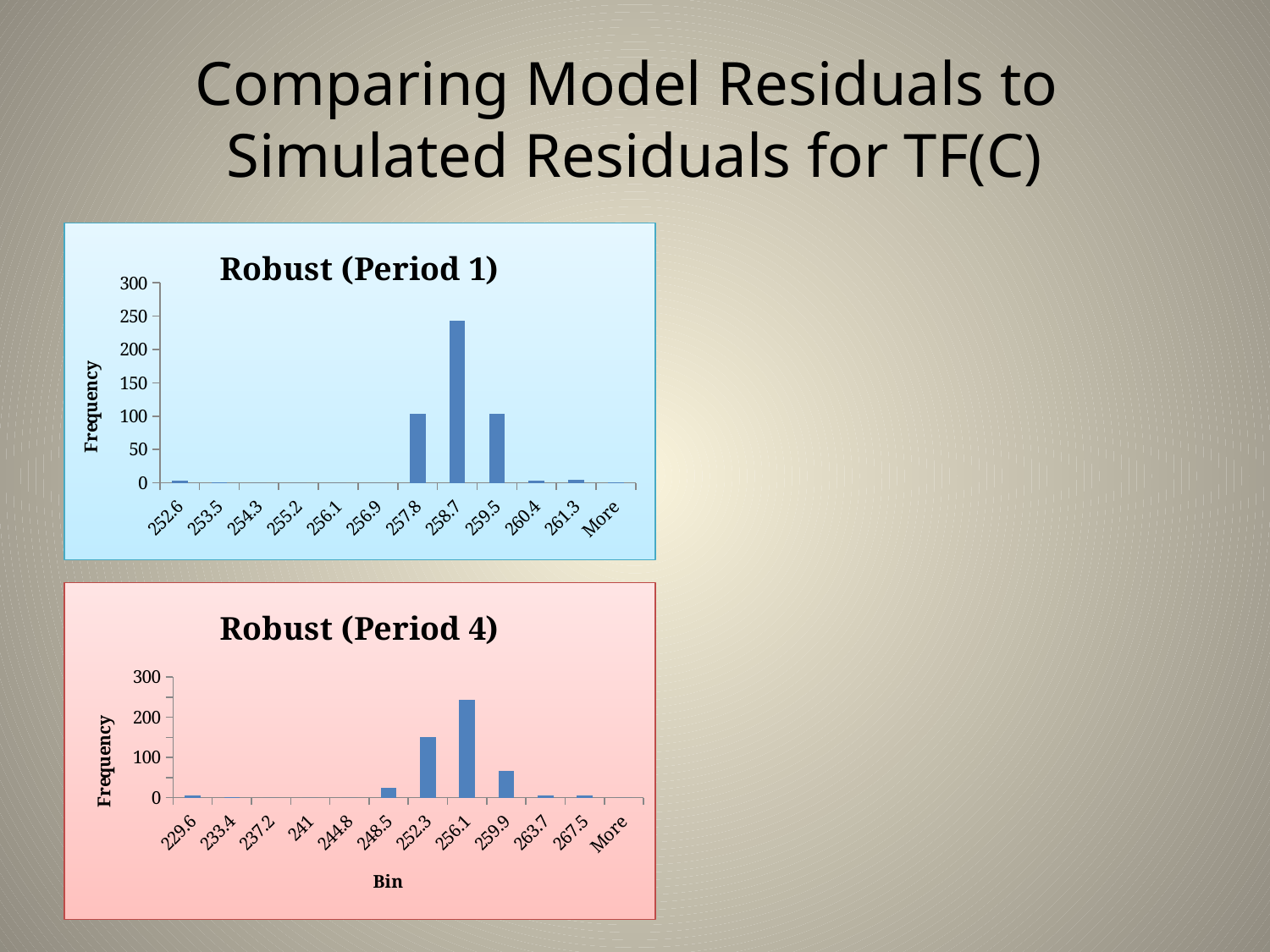
In the Robust (Period 4) chart, which bin has the highest frequency? 256.1 What is the x-axis title of the Robust (Period 4) chart? Bin In the Robust (Period 1) chart, is the frequency for bin 257.8 greater or less than 150? less In the Robust (Period 4) chart, is the frequency for bin 252.3 greater or less than 100? greater In the Robust (Period 1) chart, is the frequency for bin 258.7 greater or less than 200? greater How many bins are shown on the x axis of the Robust (Period 1) chart? 12 What kind of chart is the Robust (Period 4) chart? Bar chart How many bins are shown on the x axis of the Robust (Period 4) chart? 12 In the Robust (Period 1) chart, which bin has the highest frequency? 258.7 In the Robust (Period 4) chart, which bin has the larger frequency, 252.3 or 259.9? 252.3 In the Robust (Period 1) chart, which bin has the larger frequency, 258.7 or 259.5? 258.7